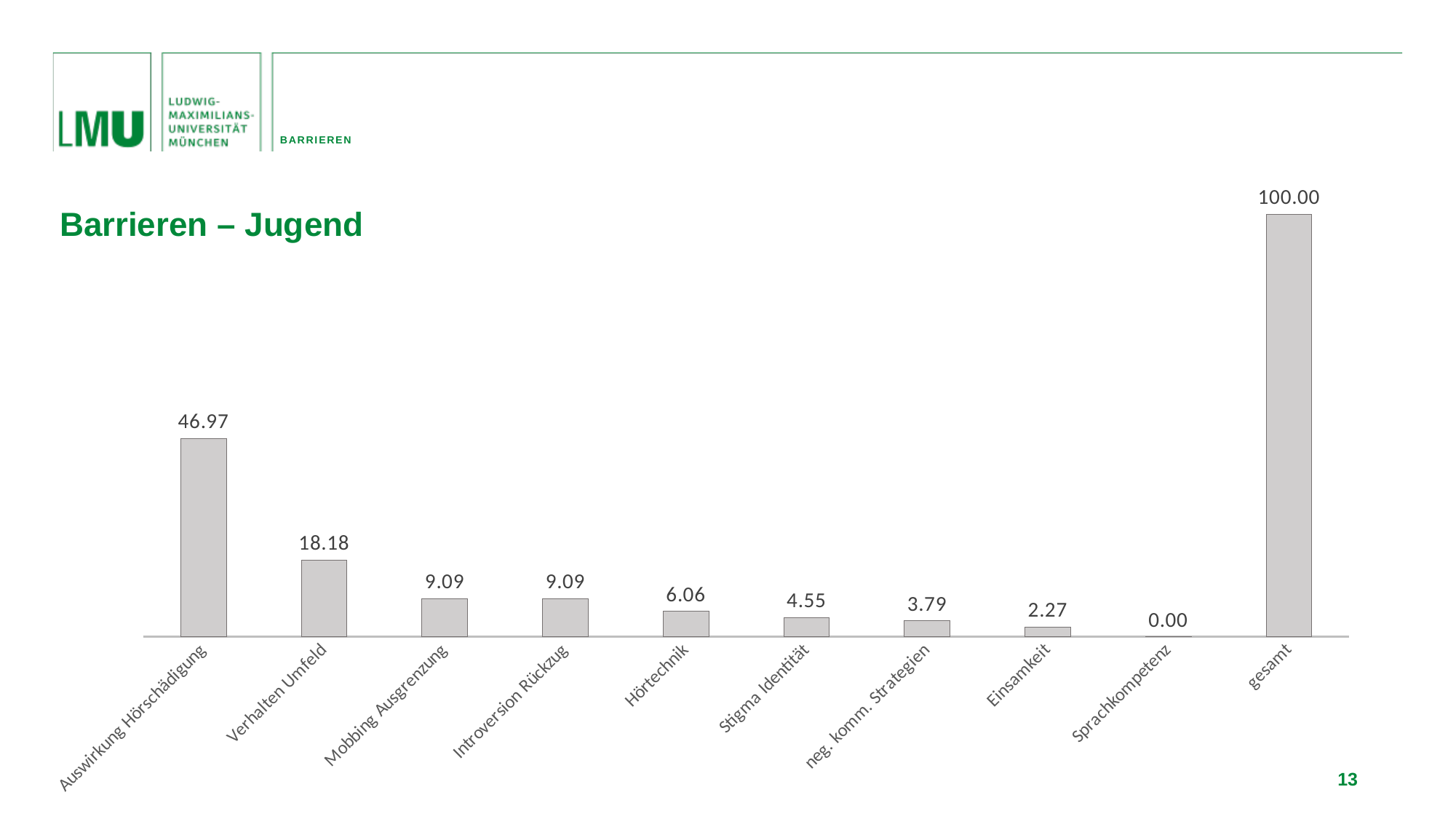
Which is larger, the value for Stigma Identität or the value for Einsamkeit? Stigma Identität What is the value for Verhalten Umfeld? 18.18 What is the value for Auswirkung Hörschädigung? 46.97 How many categories are shown on the x axis? 10 Which category has the highest value? gesamt What kind of chart is shown on the slide? bar chart What is the difference between the values for neg. komm. Strategien and Einsamkeit? 1.52 Which category has the lowest value? Sprachkompetenz What is the value for Sprachkompetenz? 0.00 What is the title of the slide? Barrieren – Jugend What is the difference between the values for Auswirkung Hörschädigung and Verhalten Umfeld? 28.79 What is the value for Hörtechnik? 6.06